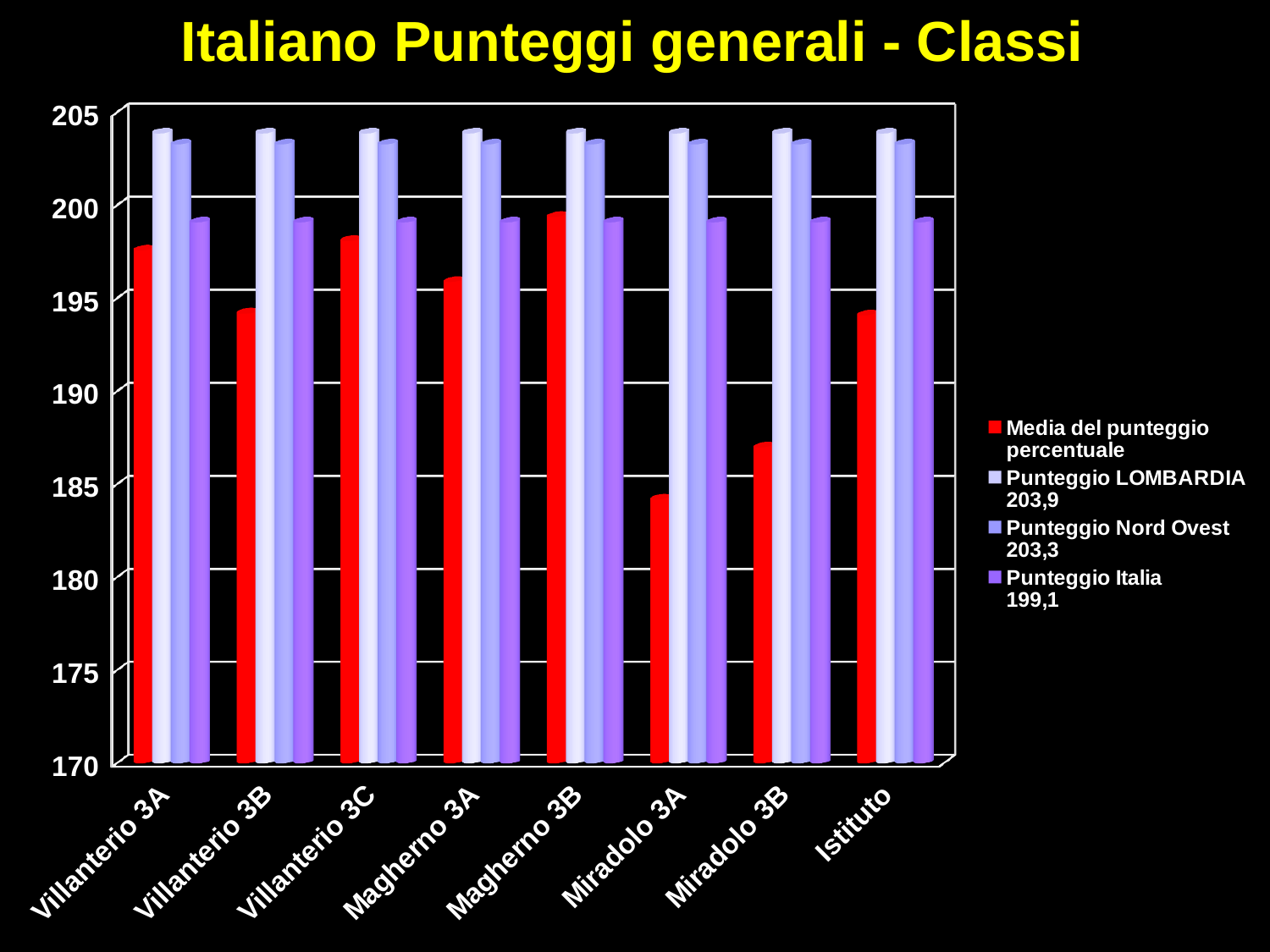
What is the value of Punteggio Italia shown in the legend? 199,1 What is the value of Punteggio LOMBARDIA shown in the legend? 203,9 How many series does the legend list? 4 How many categories are shown on the x axis? 8 What type of chart is shown on the slide? bar chart Is the Media del punteggio percentuale for Miradolo 3A greater or less than 185? less What is the difference between Punteggio LOMBARDIA and Punteggio Italia? 4,8 What is the title of the chart? Italiano Punteggi generali - Classi Is the Media del punteggio percentuale for Villanterio 3A greater or less than 195? greater Which class has the lowest Media del punteggio percentuale? Miradolo 3A Which class has the highest Media del punteggio percentuale? Magherno 3B Which has a larger Media del punteggio percentuale, Villanterio 3A or Villanterio 3B? Villanterio 3A